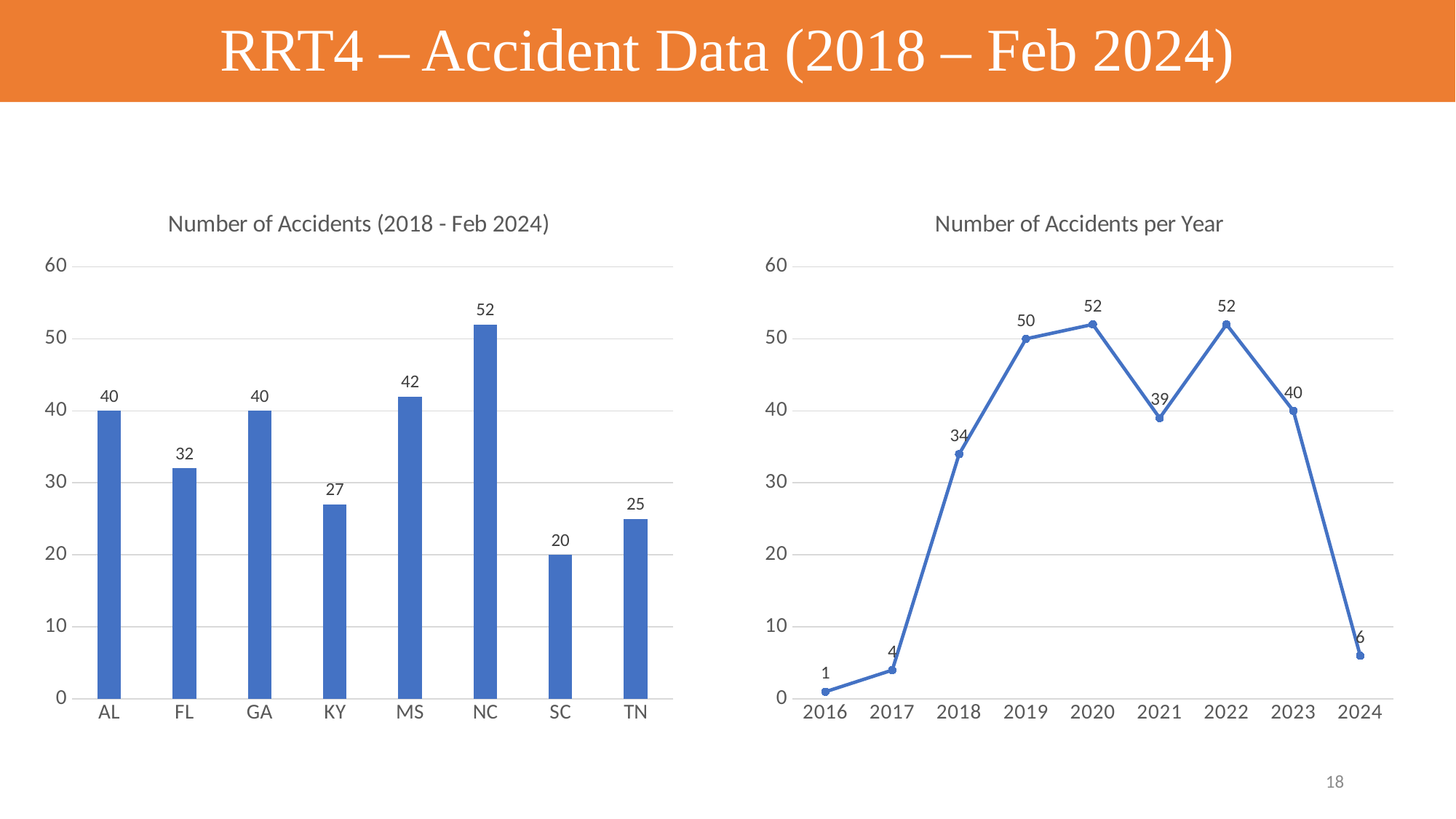
In the 'Number of Accidents (2018 - Feb 2024)' chart, which state has the lowest number of accidents? SC In the 'Number of Accidents per Year' chart, what is the value for 2021? 39 What kind of chart is the 'Number of Accidents per Year' chart? Line chart In the 'Number of Accidents per Year' chart, what is the difference between the values for 2023 and 2024? 34 In the 'Number of Accidents (2018 - Feb 2024)' chart, which is larger, the value for FL or the value for TN? FL In the 'Number of Accidents (2018 - Feb 2024)' chart, what is the difference between the values for MS and KY? 15 In the 'Number of Accidents per Year' chart, which year has the lowest value? 2016 In the 'Number of Accidents (2018 - Feb 2024)' chart, which state has the highest number of accidents? NC How many years are plotted in the 'Number of Accidents per Year' chart? 9 In the 'Number of Accidents (2018 - Feb 2024)' chart, what is the value for NC? 52 What kind of chart is the 'Number of Accidents (2018 - Feb 2024)' chart? Bar chart How many states are shown in the 'Number of Accidents (2018 - Feb 2024)' chart? 8